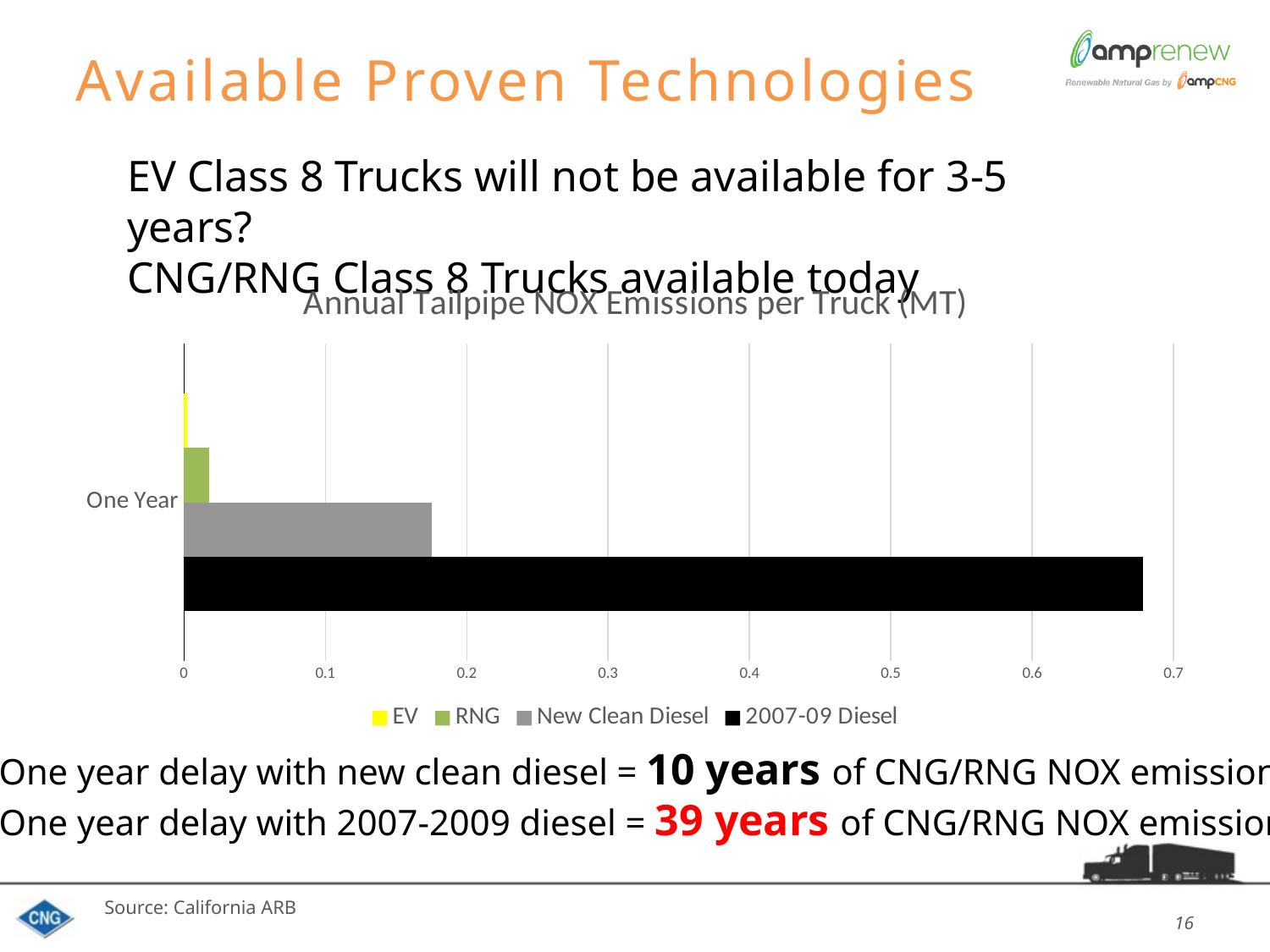
How many series does the chart legend list? 4 Is the value for New Clean Diesel greater or less than 0.2? less Is the value for 2007-09 Diesel greater or less than 0.6? greater What is the title of the chart? Annual Tailpipe NOX Emissions per Truck (MT) Is the value for RNG greater or less than 0.1? less What kind of chart is shown on the slide? bar chart How many categories are shown on the vertical axis of the chart? 1 What colour is used for the EV series in the chart? yellow Which series has the lowest annual tailpipe NOX emissions per truck? EV Which is larger, the value for RNG or the value for New Clean Diesel? New Clean Diesel Which series has the highest annual tailpipe NOX emissions per truck? 2007-09 Diesel